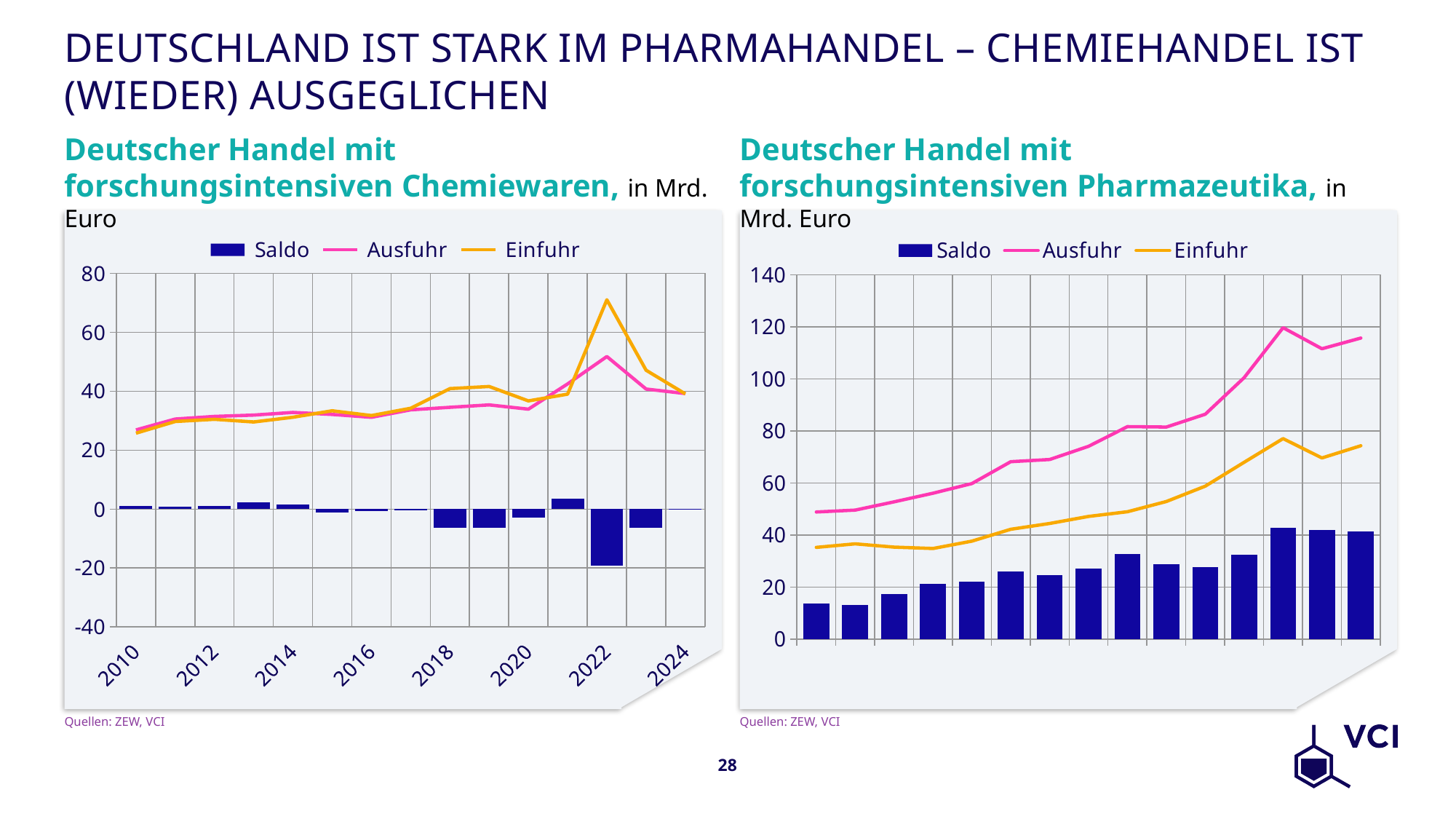
On the left chart (Chemiewaren), is the Ausfuhr value for 2010 greater or less than 40? less How many series does the legend of the left chart (Chemiewaren) list? 3 On the left chart (Chemiewaren), is the Saldo value for 2022 greater or less than 0? less On the left chart (Chemiewaren), which is larger in 2022, Ausfuhr or Einfuhr? Einfuhr How many years are shown on the x axis of the left chart (Chemiewaren), from 2010 to 2024? 15 On the right chart (Pharmazeutika), is the highest Ausfuhr value greater or less than 100? greater What kind of chart is the right chart (Pharmazeutika)? Combined bar and line chart On the right chart (Pharmazeutika), does the Ausfuhr line generally rise or fall from left to right? rise On the left chart (Chemiewaren), in which year is the Saldo bar lowest? 2022 On the right chart (Pharmazeutika), which line is higher throughout, Ausfuhr or Einfuhr? Ausfuhr On the left chart (Chemiewaren), in which year does the Einfuhr line reach its highest value? 2022